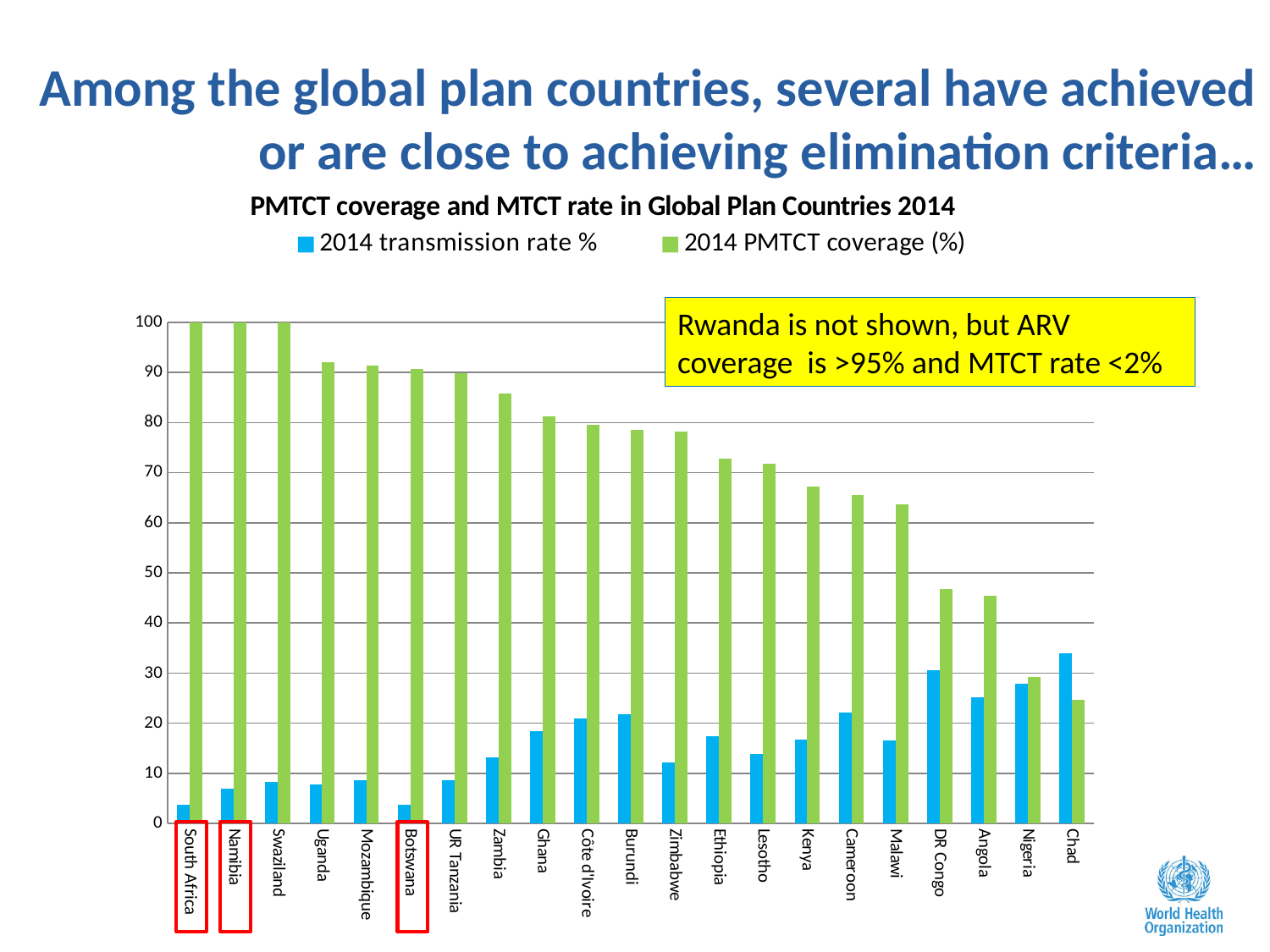
Which is larger for Chad: the 2014 transmission rate % or the 2014 PMTCT coverage (%)? 2014 transmission rate % Which country has the highest 2014 transmission rate %? Chad Which country has the higher 2014 PMTCT coverage (%), Uganda or Angola? Uganda What is the title of the chart? PMTCT coverage and MTCT rate in Global Plan Countries 2014 Do the 2014 PMTCT coverage (%) values generally rise or fall from left to right along the x axis? fall How many series does the legend list? 2 What kind of chart is shown on the slide? bar chart What is the 2014 PMTCT coverage (%) for South Africa? 100 How many countries are shown on the x axis of the chart? 21 Is the 2014 transmission rate % for Zimbabwe greater or less than 20? less Is the 2014 PMTCT coverage (%) for Kenya greater or less than 60? greater Which country has the lowest 2014 PMTCT coverage (%)? Chad